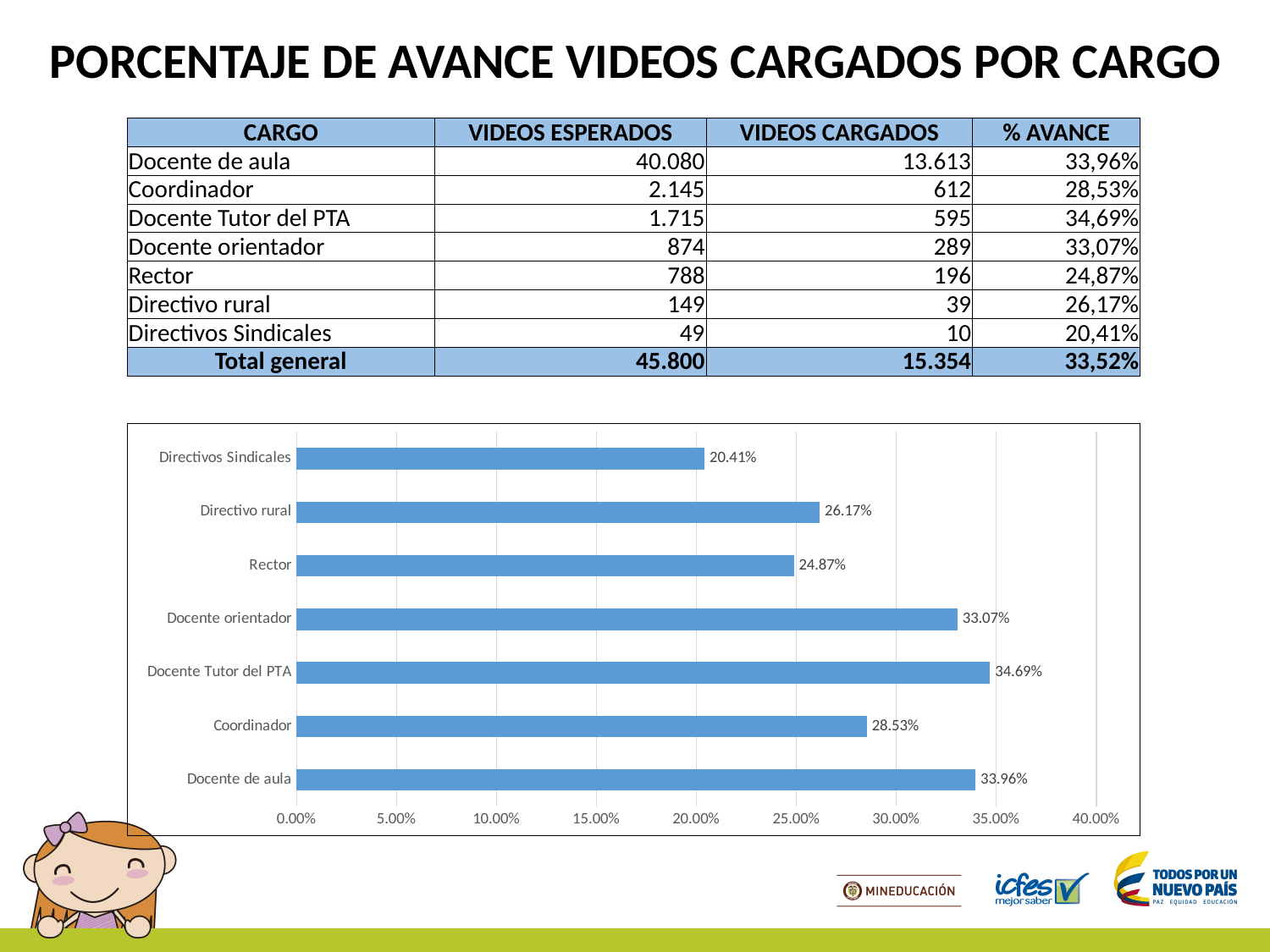
What is the difference between the values for Docente Tutor del PTA and Coordinador in the chart? 6.16% What is the difference between the values for Docente de aula and Rector in the chart? 9.09% Is the value for Coordinador in the chart greater or less than 25.00%? greater What is the value shown for Directivo rural in the chart? 26.17% What kind of chart is shown on the slide? bar chart What is the value shown for Rector in the chart? 24.87% Which category has the highest value in the chart? Docente Tutor del PTA What is the value shown for Docente de aula in the chart? 33.96% Which has a larger value in the chart, Docente orientador or Coordinador? Docente orientador How many categories are shown in the chart? 7 What is the highest value shown on the x axis of the chart? 40.00% Which category has the lowest value in the chart? Directivos Sindicales